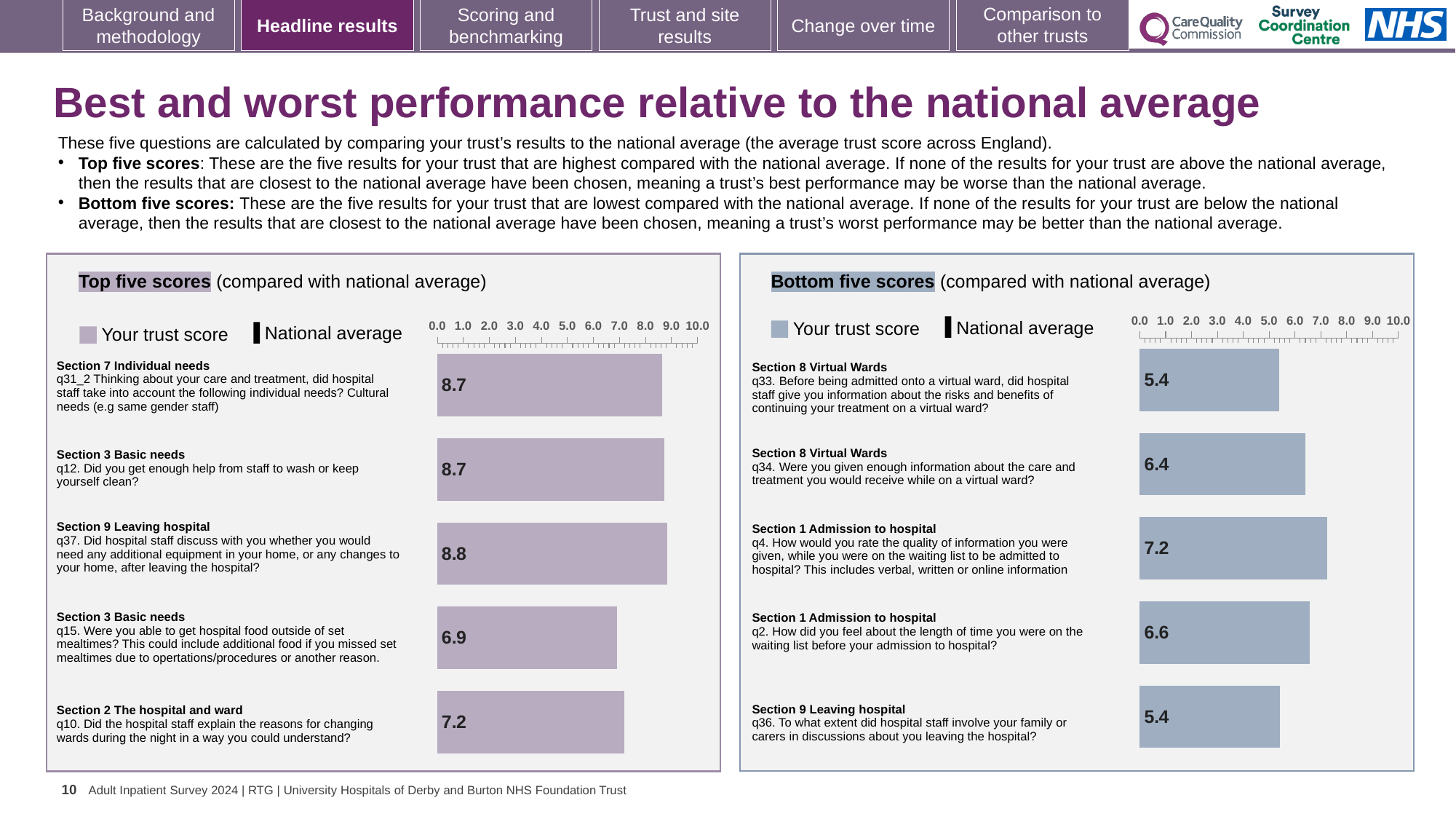
In the 'Bottom five scores' chart, what is the difference between the scores for q4 and q33? 1.8 In the 'Top five scores' chart, which question has the highest trust score? q37 (Section 9 Leaving hospital) In the 'Bottom five scores' chart, which question has the highest trust score? q4 (Section 1 Admission to hospital) What type of chart is used for the 'Top five scores'? bar chart In the 'Top five scores' chart, which question has the lowest trust score? q15 (Section 3 Basic needs) In the 'Top five scores' chart, what is the difference between the scores for q37 and q15? 1.9 In the 'Bottom five scores' chart, what is the trust score for q34 (information about care and treatment on a virtual ward)? 6.4 In the 'Bottom five scores' chart, what is the trust score for q2 (length of time on the waiting list)? 6.6 In the 'Bottom five scores' chart, is the score for q34 larger or smaller than the score for q2? smaller In the 'Top five scores' chart, what is the trust score for q10 (Did the hospital staff explain the reasons for changing wards during the night)? 7.2 How many questions are shown in the 'Bottom five scores' chart? 5 In the 'Top five scores' chart, what is the trust score for q12 (Did you get enough help from staff to wash or keep yourself clean?)? 8.7